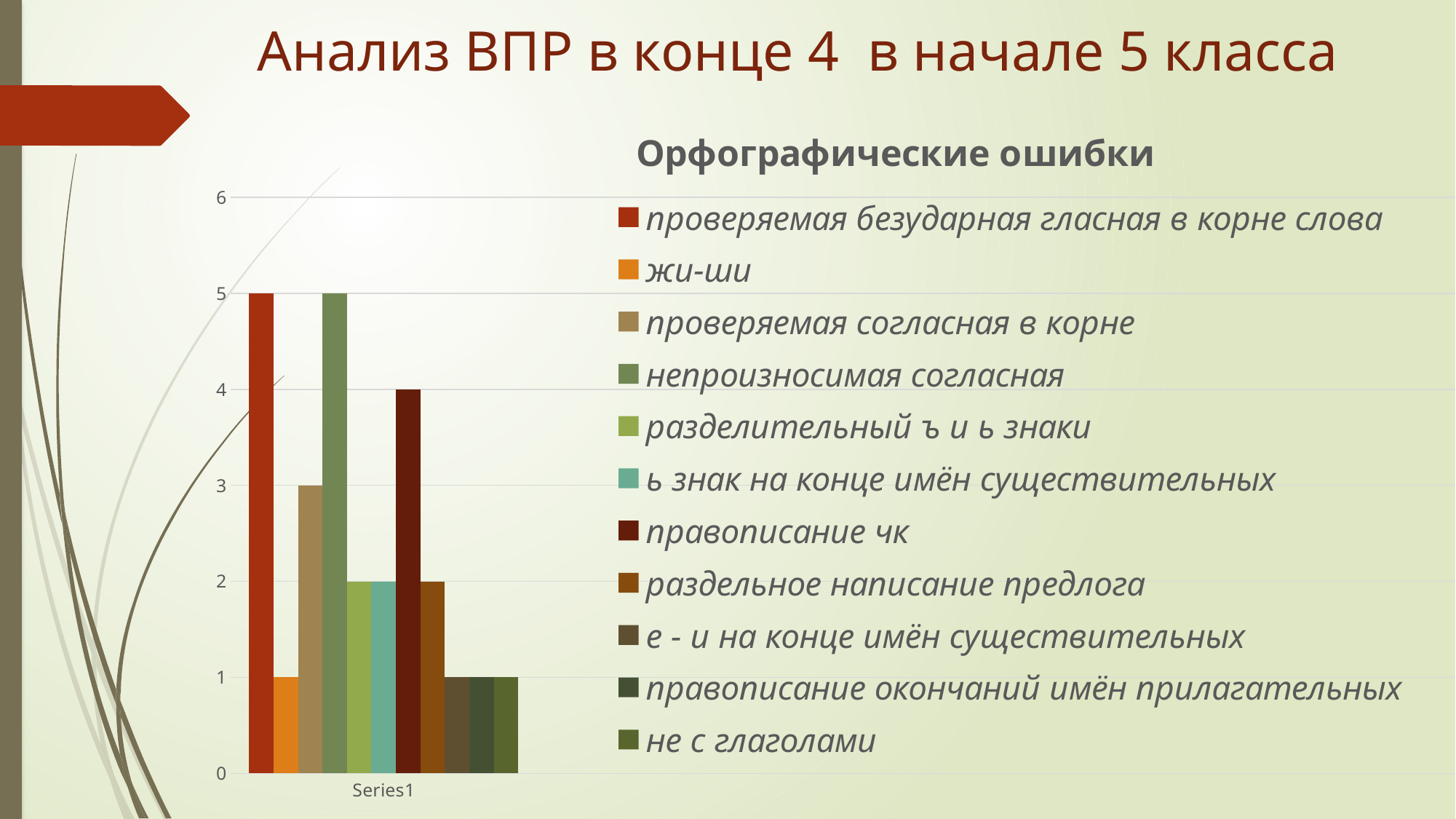
Is the value for 'правописание чк' greater or less than 3? greater What is the value for 'не с глаголами'? 1 What type of chart is shown on the slide? bar chart What is the title of the chart? Орфографические ошибки What is the value for 'жи-ши'? 1 What is the value for 'раздельное написание предлога'? 2 How many series does the chart legend list? 11 What is the value for 'проверяемая согласная в корне'? 3 What is the difference between the value for 'непроизносимая согласная' and the value for 'проверяемая согласная в корне'? 2 What is the value for 'проверяемая безударная гласная в корне слова'? 5 What is the value for 'правописание чк'? 4 Which is larger, the value for 'проверяемая согласная в корне' or the value for 'правописание чк'? правописание чк